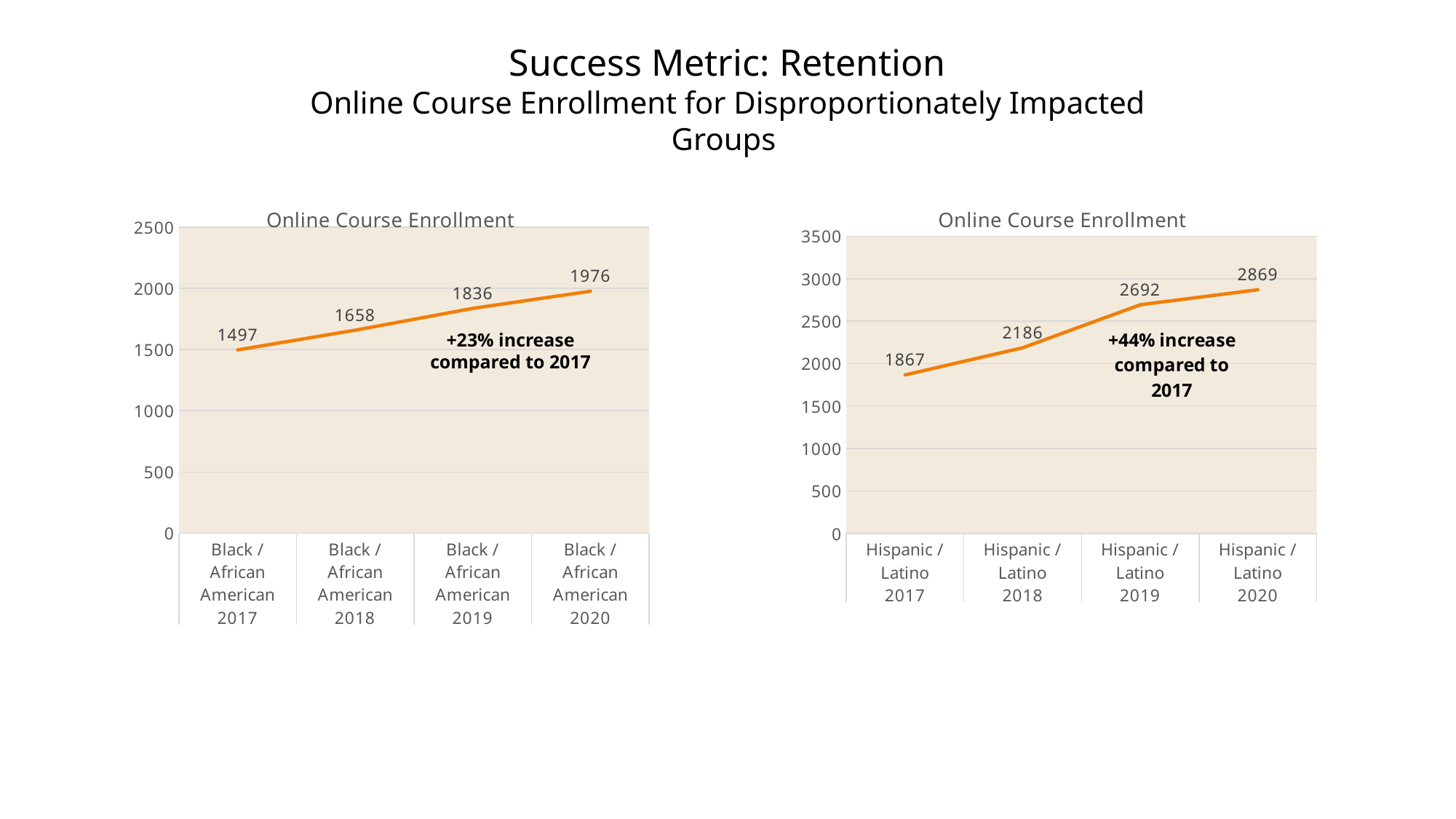
How many data points are plotted in the right chart (Hispanic / Latino)? 4 In the right chart (Hispanic / Latino), what is the difference in enrollment between 2019 and 2018? 506 What kind of chart is the left chart (Black / African American)? Line chart In the right chart (Hispanic / Latino), do the enrollment values rise or fall from 2017 to 2020? Rise Which is larger: Black / African American enrollment in 2020 (left chart) or Hispanic / Latino enrollment in 2017 (right chart)? Black / African American enrollment in 2020 In the right chart (Hispanic / Latino), which year has the highest enrollment? 2020 In the left chart (Black / African American), what is the difference in enrollment between 2020 and 2017? 479 In the left chart (Black / African American), what is the online course enrollment for 2020? 1976 In the left chart (Black / African American), what is the online course enrollment for 2017? 1497 In the left chart (Black / African American), which year has the lowest enrollment? 2017 In the right chart (Hispanic / Latino), what is the online course enrollment for 2018? 2186 In the right chart (Hispanic / Latino), what is the online course enrollment for 2019? 2692